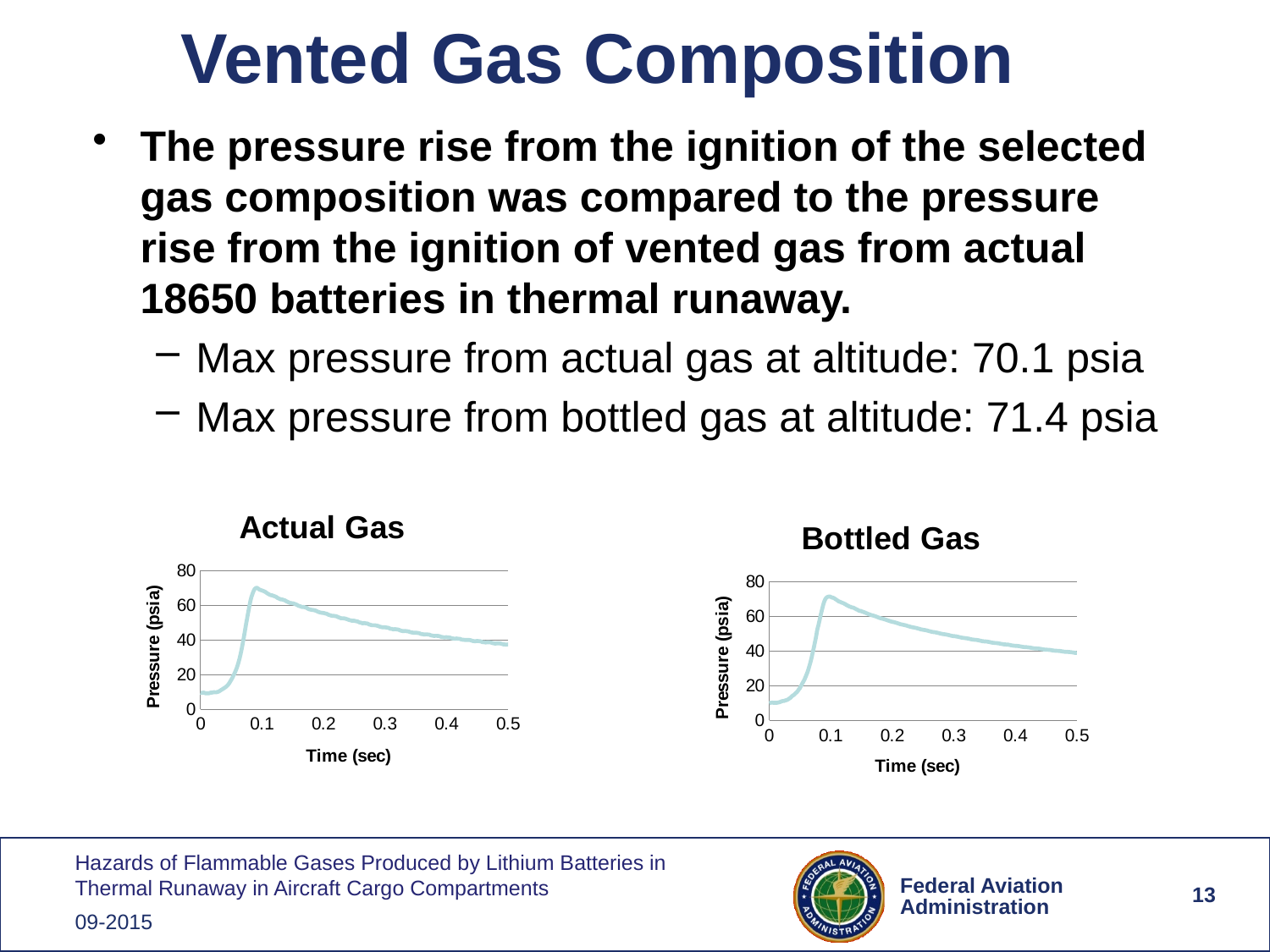
In the Bottled Gas chart, does the pressure rise or fall between 0 and 0.1 sec? rise According to the slide, what is the max pressure shown in the Bottled Gas chart? 71.4 psia Which chart shows the higher maximum pressure, Actual Gas or Bottled Gas? Bottled Gas According to the slide, what is the max pressure shown in the Actual Gas chart? 70.1 psia What kind of chart is the Actual Gas chart? line chart In the Bottled Gas chart, is the pressure at time 0 greater or less than 20? less What is the y-axis label on the Actual Gas chart? Pressure (psia) In the Actual Gas chart, is the peak pressure greater or less than 60? greater In the Actual Gas chart, does the pressure rise or fall between 0.1 sec and 0.5 sec? fall In the Actual Gas chart, is the pressure at 0.2 sec greater or less than 60? less What is the title of the chart on the right side of the slide? Bottled Gas